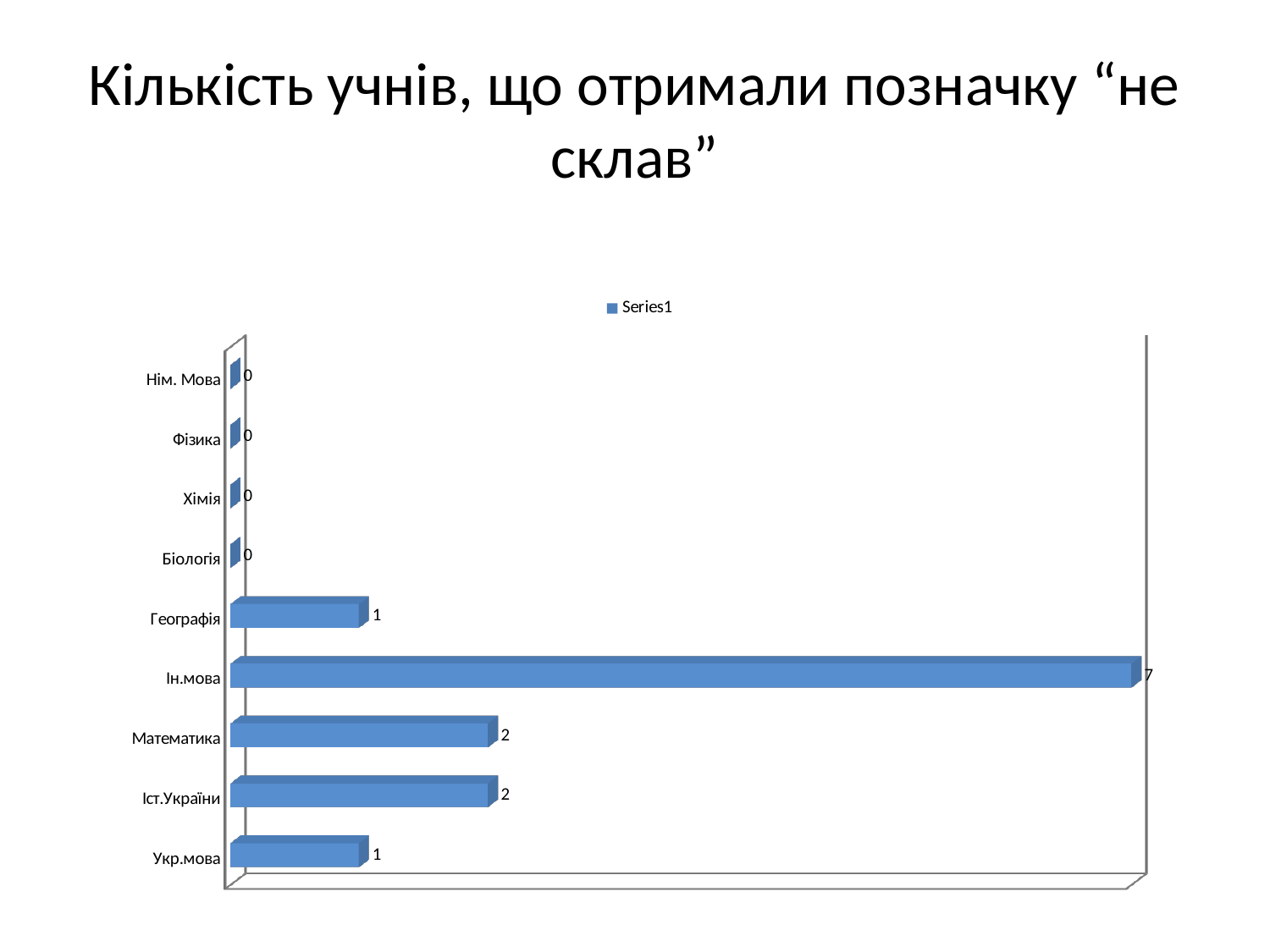
What is the difference between the values for Ін.мова and Математика? 5 What is the title of the slide? Кількість учнів, що отримали позначку “не склав” How many series does the legend list? 1 What is the value for Фізика? 0 How many categories are shown on the chart? 9 Which category has the highest value? Ін.мова What kind of chart is shown on the slide? Bar chart Which is larger, the value for Ін.мова or the value for Іст.України? Ін.мова What is the difference between the values for Іст.України and Укр.мова? 1 What is the value for Математика? 2 What is the value for Географія? 1 What is the value for Ін.мова? 7